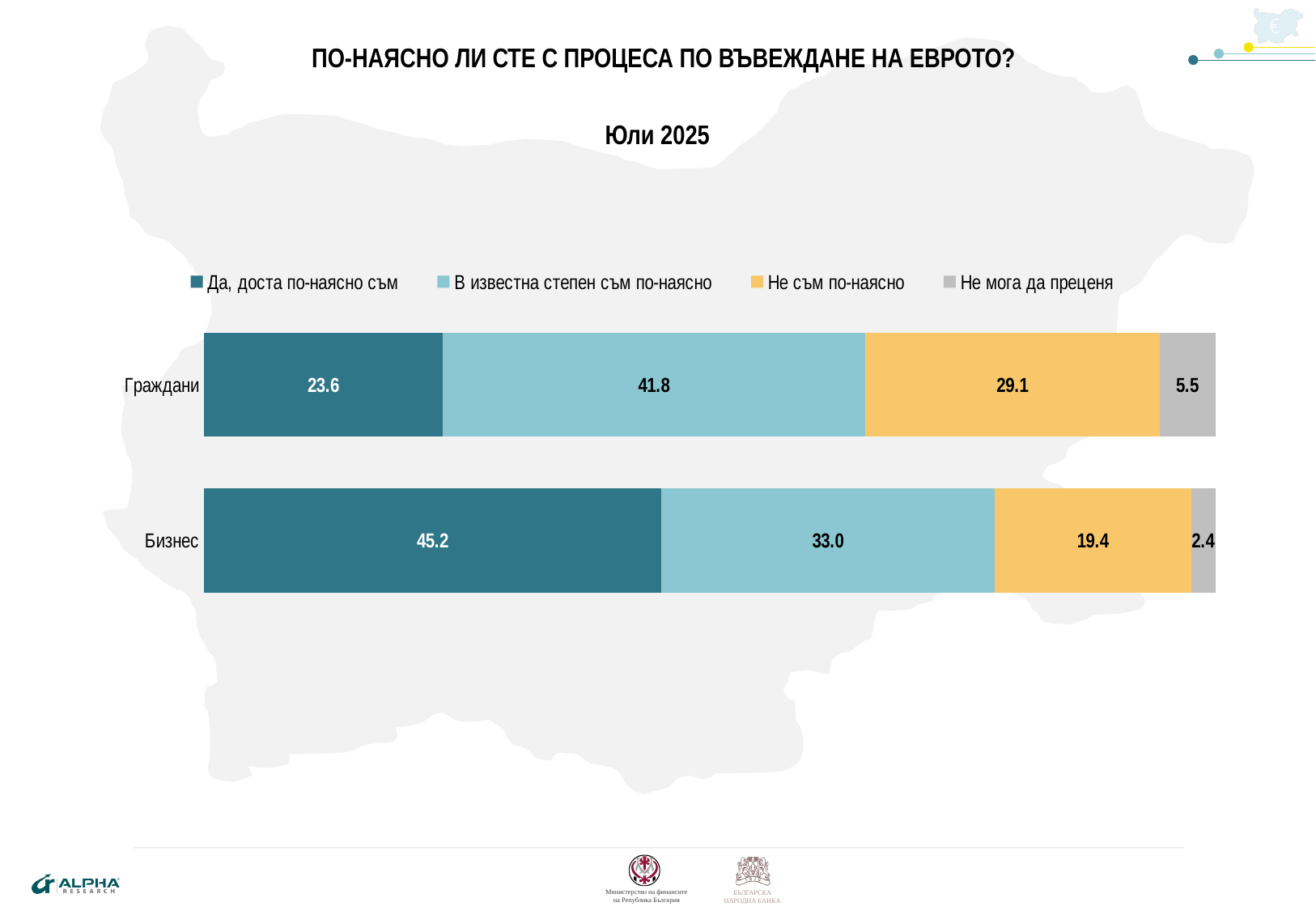
How many series does the legend list? 4 What is the difference between the "Да, доста по-наясно съм" values for Бизнес and Граждани? 21.6 Which series has the smallest value in the Бизнес bar? Не мога да преценя What is the value for "В известна степен съм по-наясно" for Бизнес? 33.0 What is the total of the Граждани stacked bar? 100.0 Which category has the higher value for "Да, доста по-наясно съм", Граждани or Бизнес? Бизнес Which series has the largest value in the Граждани bar? В известна степен съм по-наясно How many categories are shown on the chart? 2 What kind of chart is shown on the slide? Stacked bar chart What is the value for "Не мога да преценя" for Бизнес? 2.4 What is the value for "Да, доста по-наясно съм" for Граждани? 23.6 What is the value for "Не съм по-наясно" for Граждани? 29.1